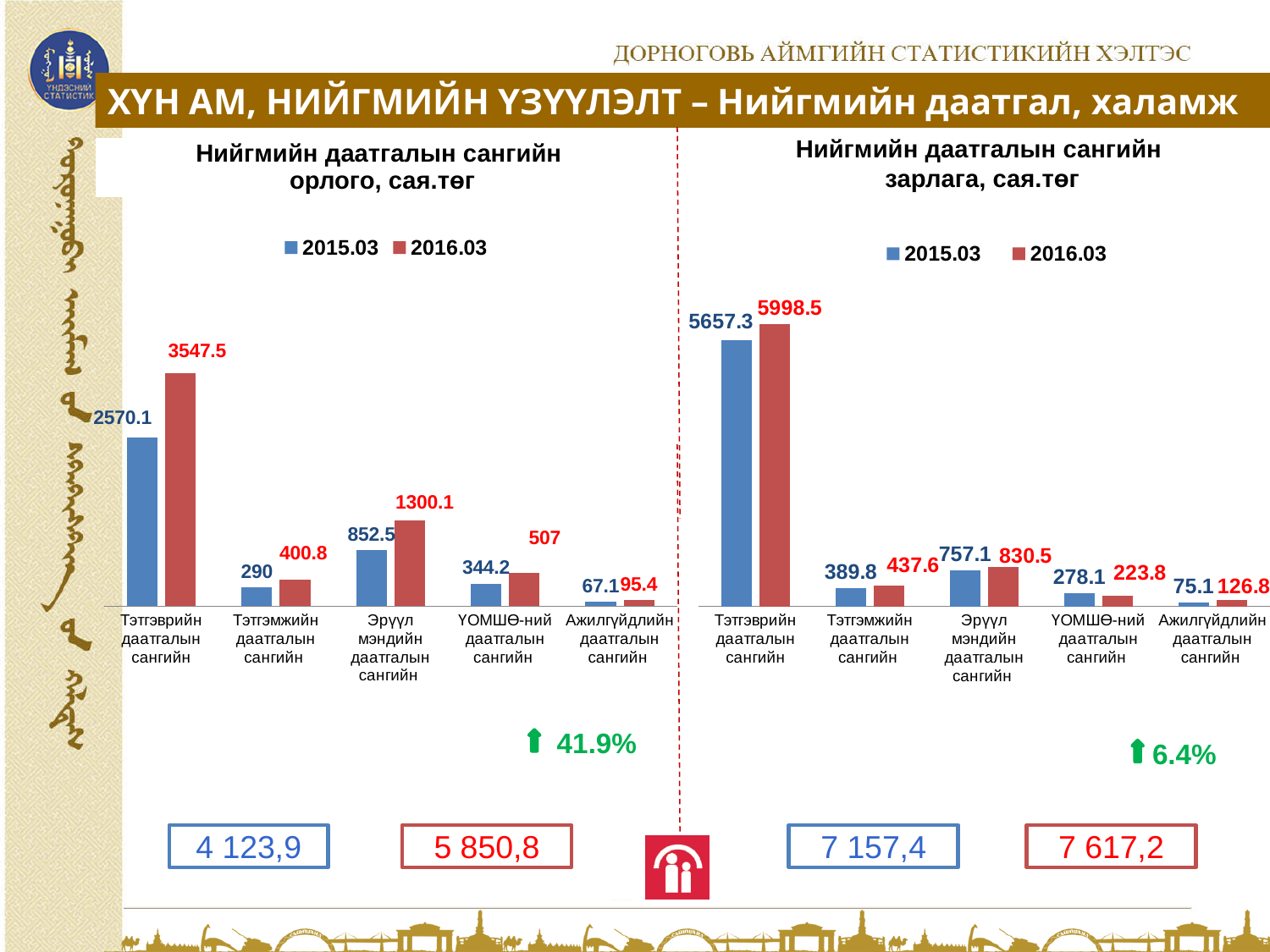
In the right chart (зарлага), which category has the highest 2015.03 value? Тэтгэврийн даатгалын сангийн In the left chart (Нийгмийн даатгалын сангийн орлого), what is the 2016.03 value for Тэтгэврийн даатгалын сангийн? 3547.5 What type of chart is the left chart (Нийгмийн даатгалын сангийн орлого)? Bar chart In the right chart (зарлага), for ҮОМШӨ-ний даатгалын сангийн, which is larger: the 2015.03 value or the 2016.03 value? 2015.03 In the left chart (орлого), what is the difference between the 2016.03 and 2015.03 values for Тэтгэмжийн даатгалын сангийн? 110.8 In the right chart (зарлага), what is the 2016.03 value for ҮОМШӨ-ний даатгалын сангийн? 223.8 In the right chart (зарлага), what is the difference between the 2016.03 and 2015.03 values for Тэтгэврийн даатгалын сангийн? 341.2 How many categories are shown on the x axis of the left chart (орлого)? 5 In the right chart (Нийгмийн даатгалын сангийн зарлага), what is the 2015.03 value for Тэтгэврийн даатгалын сангийн? 5657.3 How many series does the legend of the right chart (зарлага) list? 2 In the left chart (орлого), what is the 2015.03 value for Эрүүл мэндийн даатгалын сангийн? 852.5 In the left chart (орлого), which category has the lowest 2016.03 value? Ажилгүйдлийн даатгалын сангийн